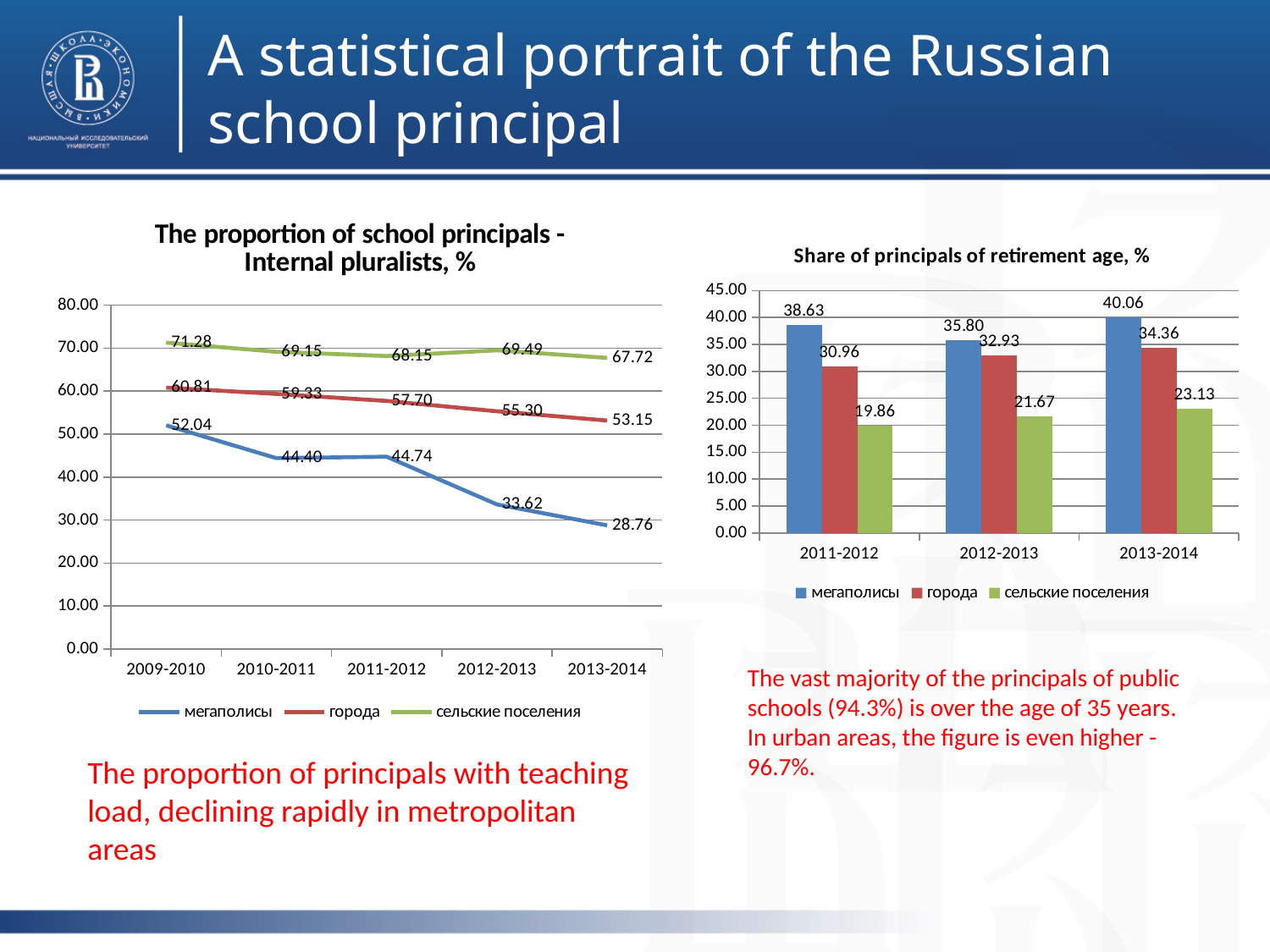
In the chart 'Share of principals of retirement age, %', which year has the highest value for мегаполисы? 2013-2014 In the chart 'Share of principals of retirement age, %', what is the value for мегаполисы in 2013-2014? 40.06 In the chart 'The proportion of school principals - Internal pluralists, %', what is the value for города in 2011-2012? 57.70 In the chart 'The proportion of school principals - Internal pluralists, %', what is the difference between the мегаполисы values in 2009-2010 and 2013-2014? 23.28 What kind of chart is 'Share of principals of retirement age, %'? bar chart In the chart 'Share of principals of retirement age, %', what is the value for сельские поселения in 2011-2012? 19.86 What kind of chart is 'The proportion of school principals - Internal pluralists, %'? line chart In the chart 'The proportion of school principals - Internal pluralists, %', what is the value for сельские поселения in 2009-2010? 71.28 In the chart 'The proportion of school principals - Internal pluralists, %', does the мегаполисы series rise or fall from 2009-2010 to 2013-2014? fall In the chart 'Share of principals of retirement age, %', what is the difference between мегаполисы and города in 2012-2013? 2.87 How many series does the legend of the chart 'The proportion of school principals - Internal pluralists, %' list? 3 In the chart 'The proportion of school principals - Internal pluralists, %', what is the value for мегаполисы in 2013-2014? 28.76